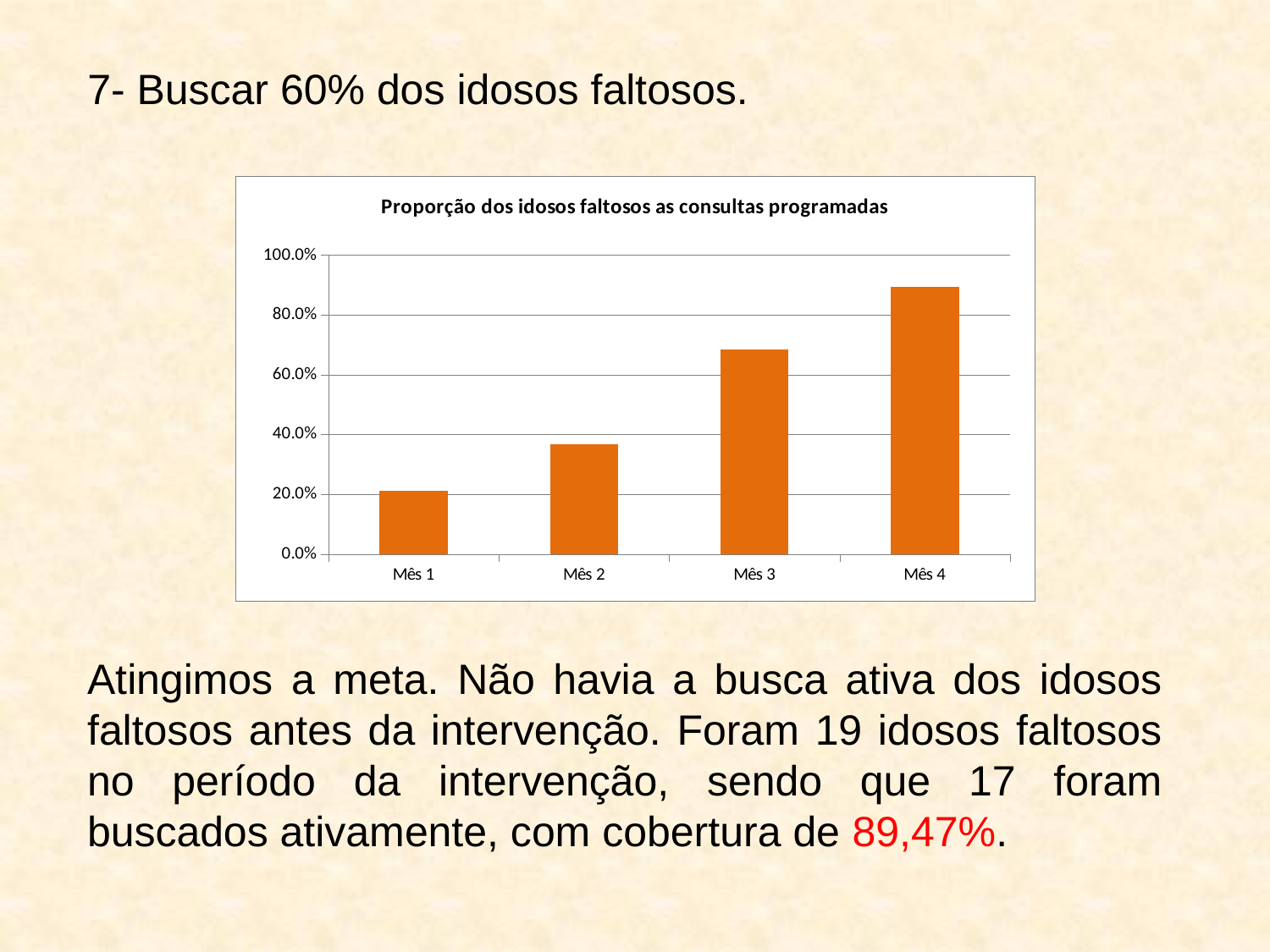
What is the title of the chart? Proporção dos idosos faltosos as consultas programadas Which month has the highest value in the chart? Mês 4 How many categories (months) are shown on the x axis of the chart? 4 Is the value for Mês 3 greater or less than 60.0%? greater What is the highest value shown on the y axis of the chart? 100.0% Is the value for Mês 2 greater or less than 20.0%? greater Do the values rise or fall from Mês 1 to Mês 4? rise Which month has the lowest value in the chart? Mês 1 Is the value for Mês 4 greater or less than 80.0%? greater Which is larger, the value for Mês 2 or the value for Mês 3? Mês 3 What kind of chart is shown on the slide? bar chart